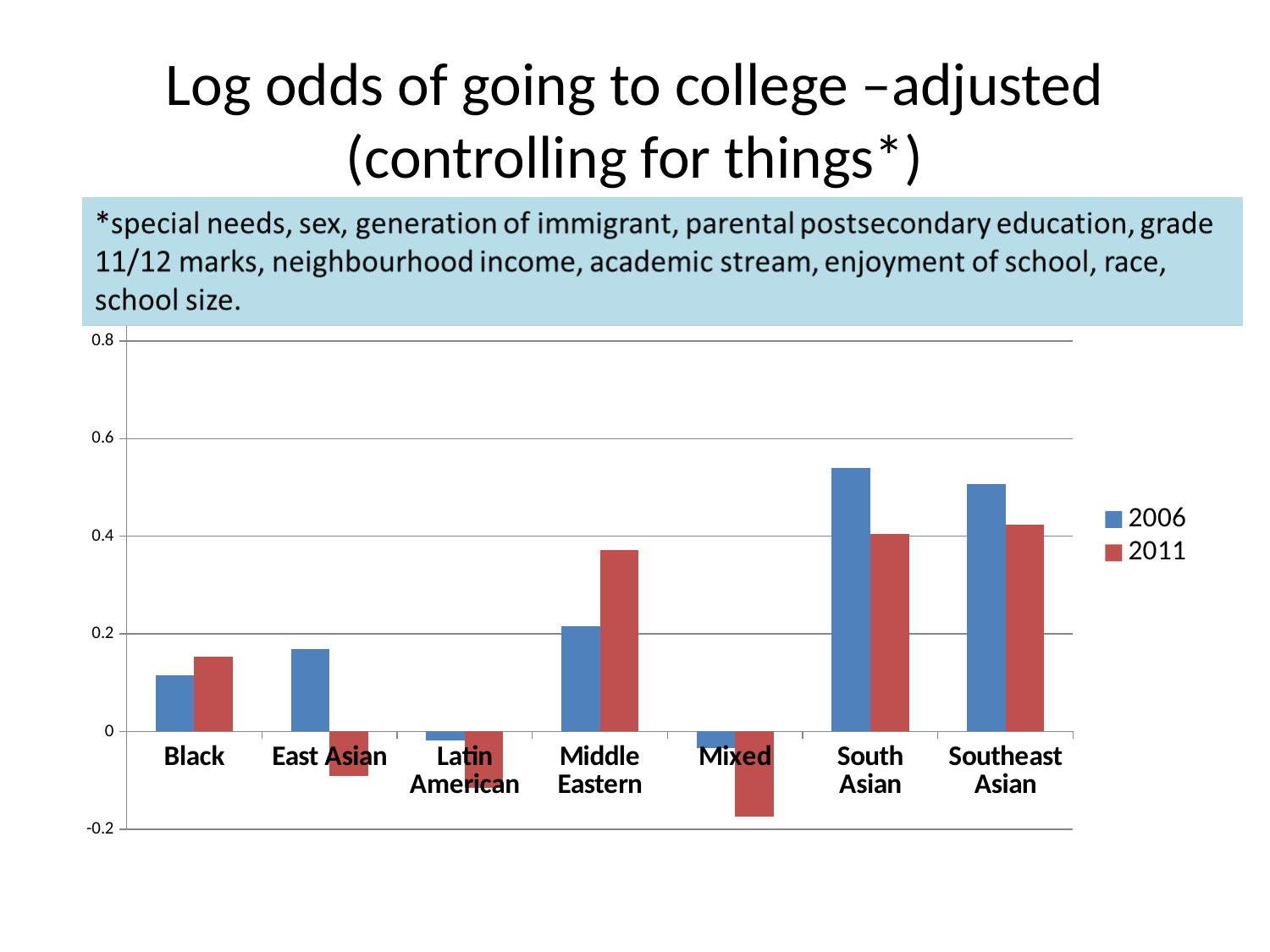
Is the value for Middle Eastern in 2011 greater or less than 0.4? less What are the two entries in the legend? 2006 and 2011 For Middle Eastern, which is larger: the 2006 value or the 2011 value? 2011 Is the value for East Asian in 2011 greater or less than 0? less For South Asian, which is larger: the 2006 value or the 2011 value? 2006 Is the value for South Asian in 2006 greater or less than 0.4? greater Which category has the highest value for 2006? South Asian What kind of chart is shown on the slide? bar chart Which category has the lowest value for 2011? Mixed How many categories are shown on the x axis? 7 How many series does the legend list? 2